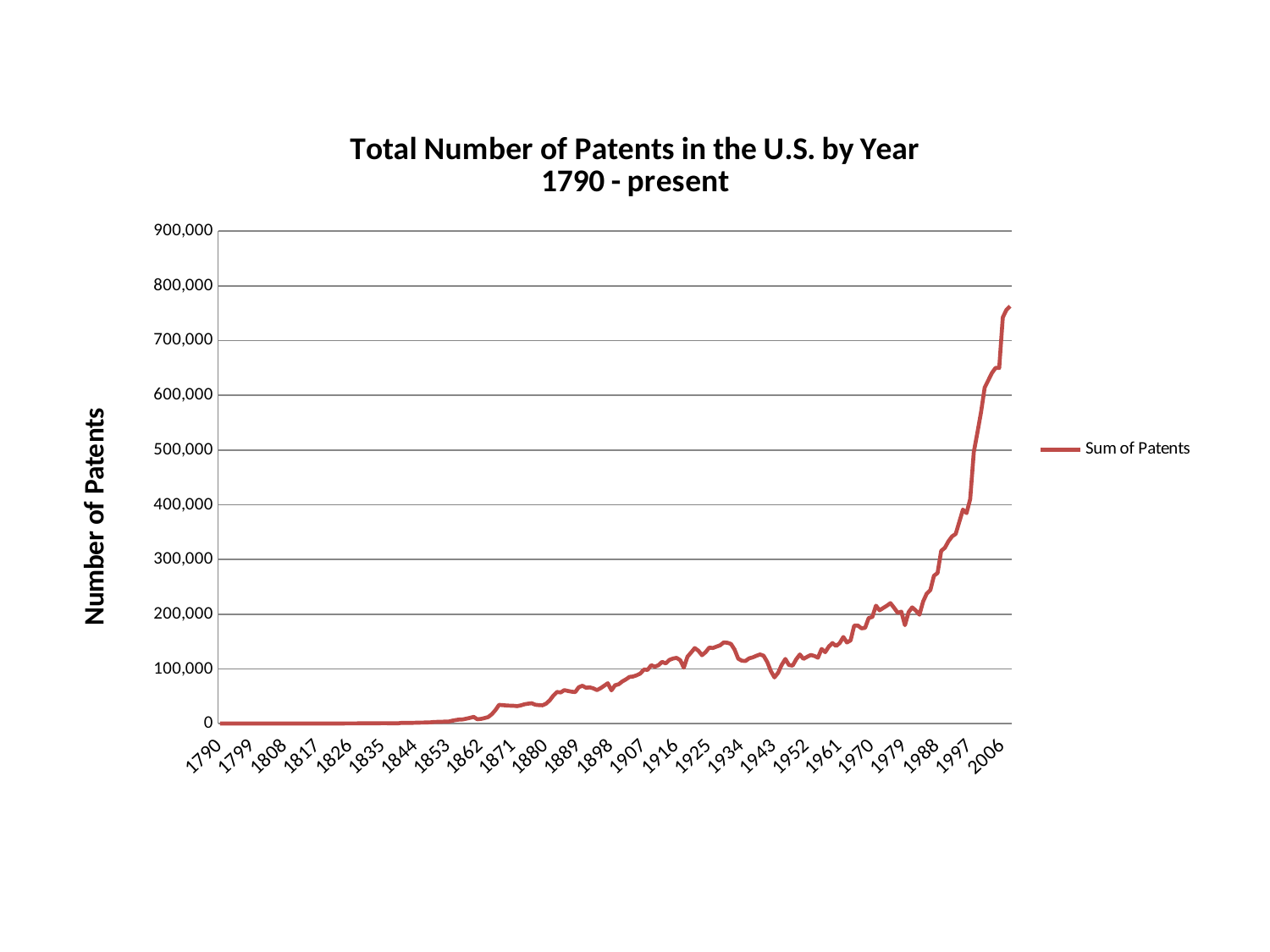
Is the value for 1880 greater or less than 100,000? less What is the name of the series shown in the legend? Sum of Patents How many series does the legend list? 1 Do the values generally rise or fall from 1790 to the present along the x axis? rise Which year has the larger value, 1925 or 1880? 1925 Is the value for 1790 greater or less than 100,000? less Is the value for 2006 greater or less than 600,000? greater What kind of chart is shown on the slide? line chart Which year has the larger value, 2006 or 1970? 2006 What is the title of the chart? Total Number of Patents in the U.S. by Year 1790 - present